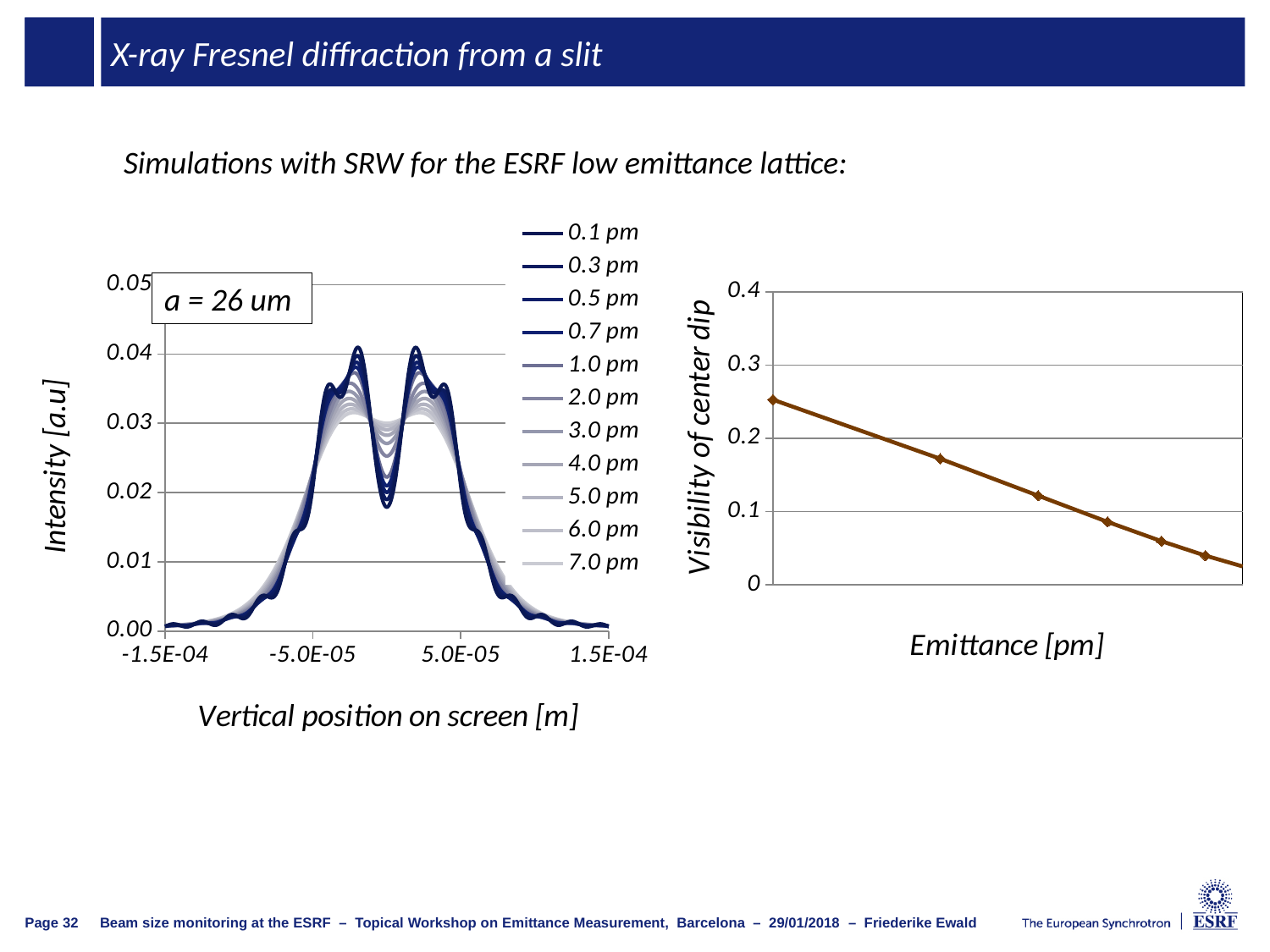
In the right chart, is the visibility of the center dip at the first (leftmost) data point greater or less than 0.2? greater In the left chart, what is the last entry in the legend? 7.0 pm In the right chart, does the visibility of the center dip rise or fall as emittance increases? fall How many series does the legend of the left chart list? 11 What kind of chart is the right chart (Visibility of center dip vs Emittance)? line chart In the left chart, what is the first entry in the legend? 0.1 pm In the right chart, which data point has the highest visibility of center dip, the leftmost or the rightmost? leftmost What kind of chart is the left chart (Intensity vs Vertical position on screen)? line chart In the left chart, is the peak intensity of the 0.1 pm curve greater or less than 0.03? greater In the right chart, is the visibility of the center dip at the last (rightmost) data point greater or less than 0.1? less